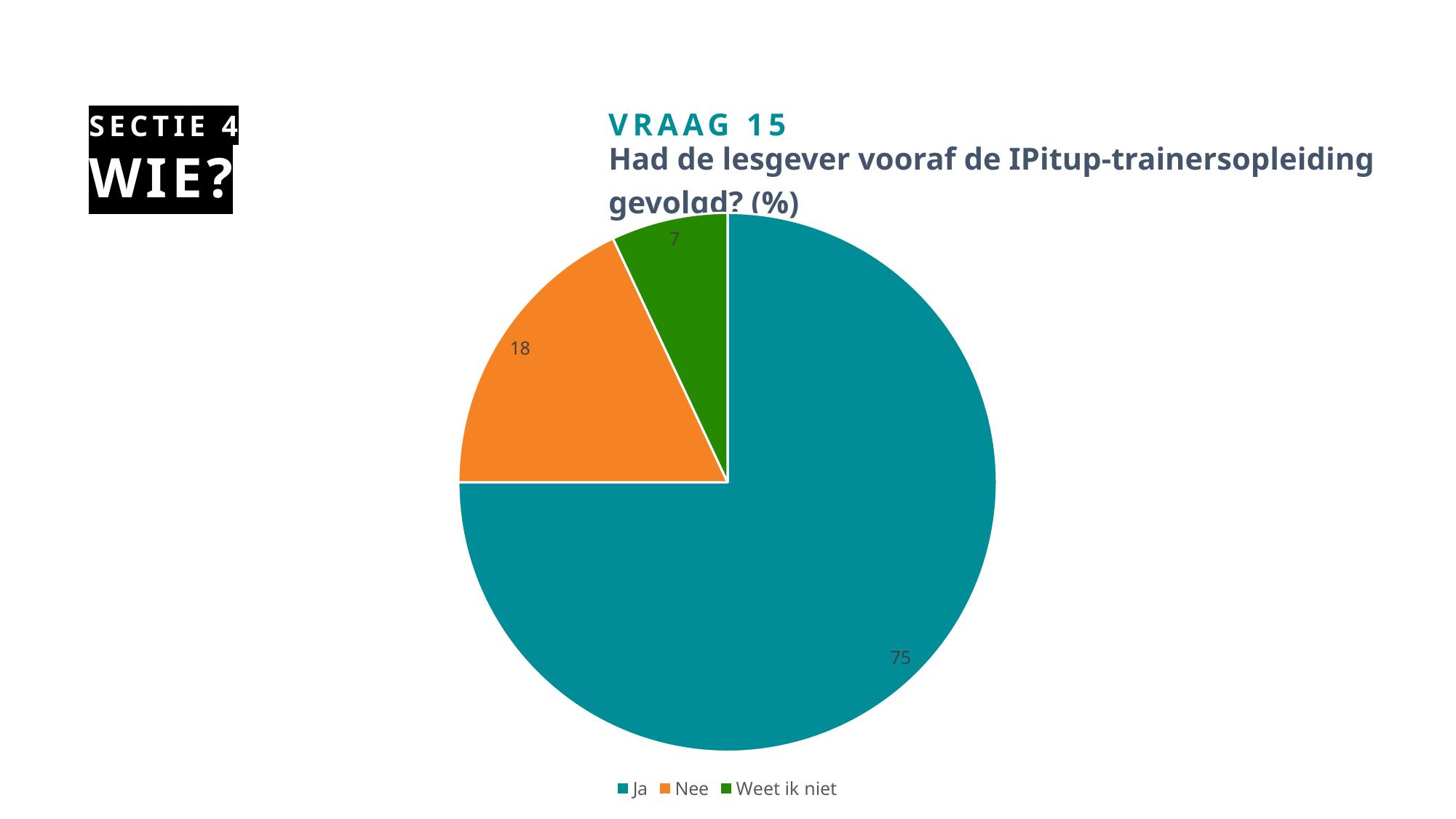
What colour is the Nee slice? orange What is the question number shown above the chart title? Vraag 15 How many categories does the pie chart have? 3 Which is larger, the value for Nee or the value for Weet ik niet? Nee Which category has the largest slice? Ja What is the difference between the values for Nee and Weet ik niet? 11 Which category has the smallest slice? Weet ik niet What kind of chart is shown on the slide? pie chart What is the difference between the values for Ja and Nee? 57 What is the value for Ja? 75 What is the value for Nee? 18 What is the value for Weet ik niet? 7